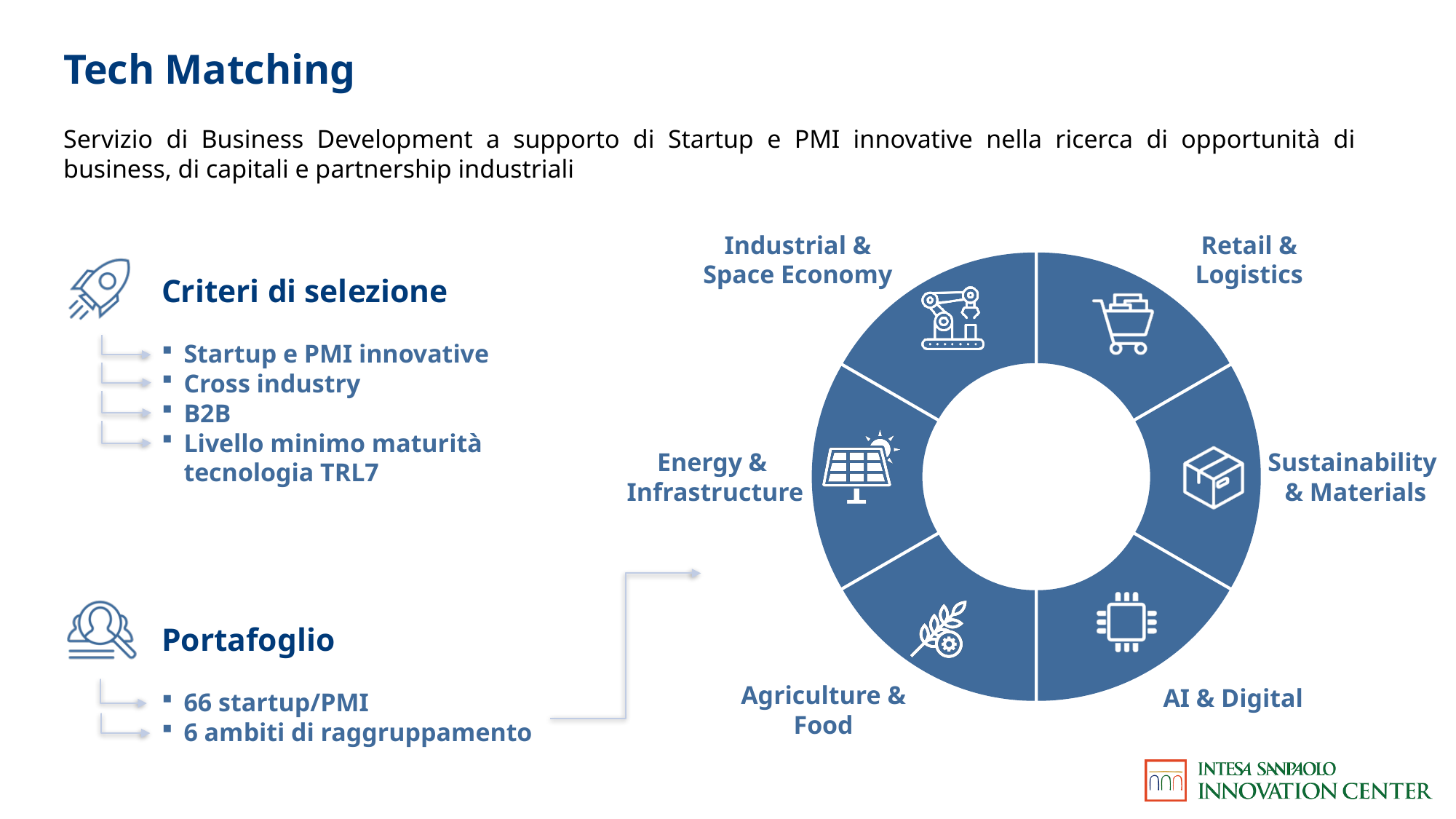
Which segment of the doughnut chart is labelled with a solar panel icon? Energy & Infrastructure What kind of chart is shown on the right side of the slide? Doughnut chart How many segments does the doughnut chart on the slide have? 6 Which segment of the doughnut chart is labelled with a shopping cart icon? Retail & Logistics According to the slide, how many startup/PMI are in the portfolio represented by the doughnut chart? 66